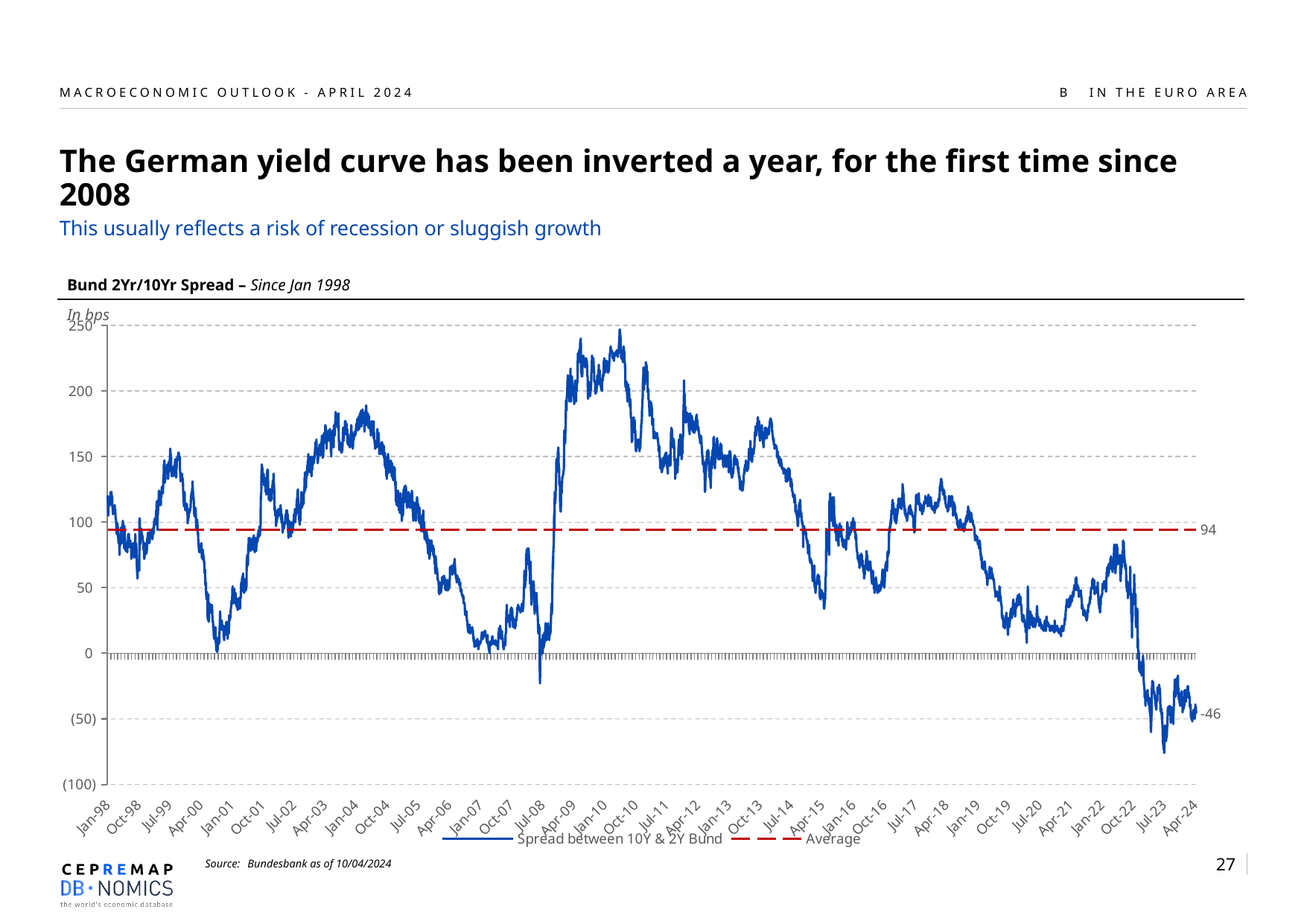
What is the labelled value of the spread at the end of the series (Apr-24)? -46 What is the title of the chart? Bund 2Yr/10Yr Spread – Since Jan 1998 Is the spread around Jan-01 greater or less than 50? less Which is larger, the Average value or the latest labelled spread value? Average What is the difference between the Average value and the latest labelled spread value? 140 Does the spread rise or fall between Oct-22 and Jul-23? fall How many series does the legend list? 2 What value is labelled on the dashed Average line? 94 Is the spread around Jan-04 greater or less than 150? greater Is the spread around Jan-10 greater or less than 200? greater What type of chart is shown on the slide? line chart